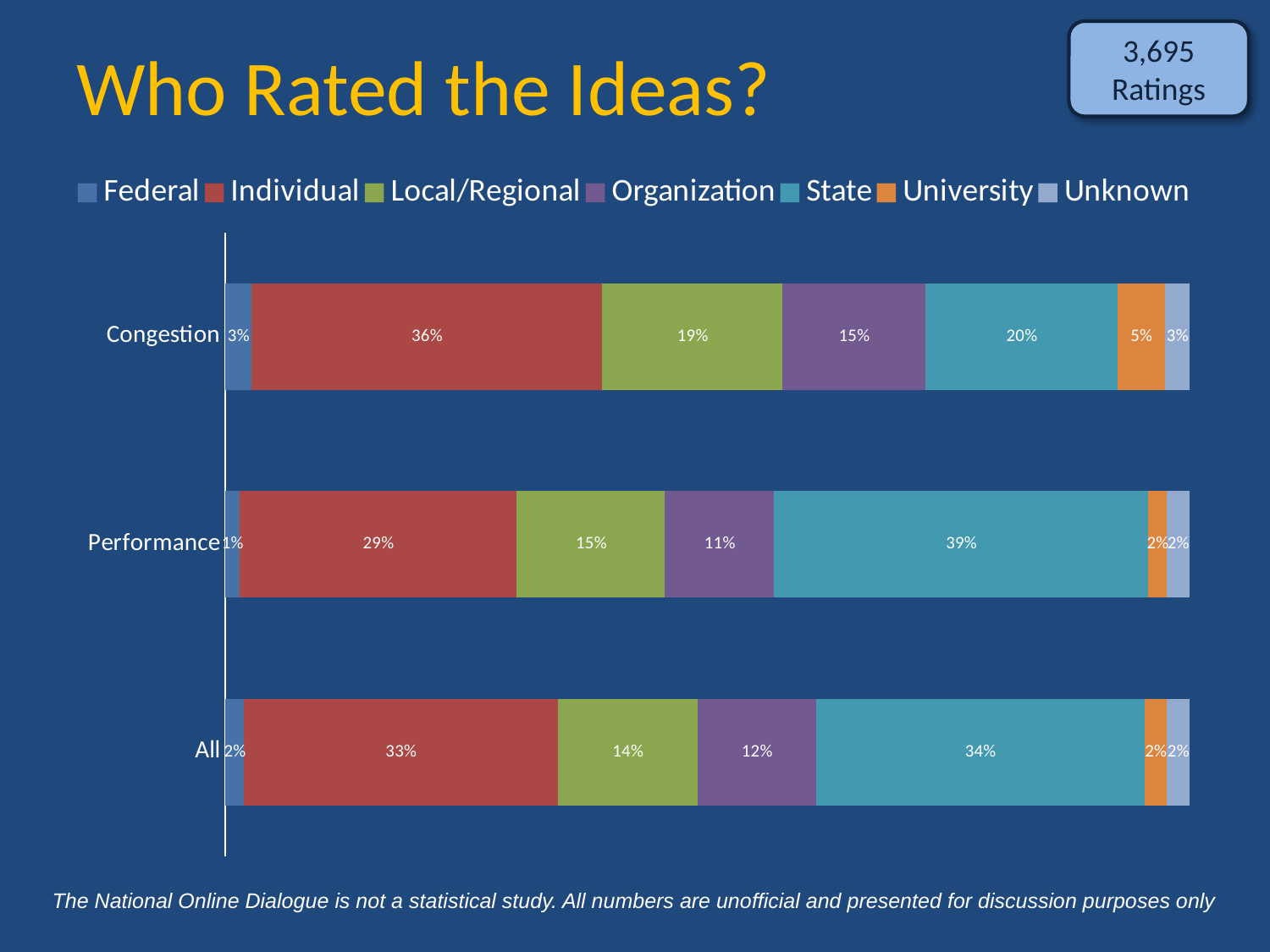
Which series has the largest share in the Congestion bar? Individual Which series has the largest share in the Performance bar? State What is the Individual share for Congestion? 36% What is the State share for Performance? 39% How many series does the legend list? 7 What is the Local/Regional share for All? 14% What is the University share for Congestion? 5% What kind of chart is shown on the slide? Stacked bar chart How many categories (bars) are shown in the chart? 3 What is the difference between the State share and the Individual share for Performance? 10% Which is larger for All: the Organization share or the Local/Regional share? Local/Regional What is the title of the chart slide? Who Rated the Ideas?